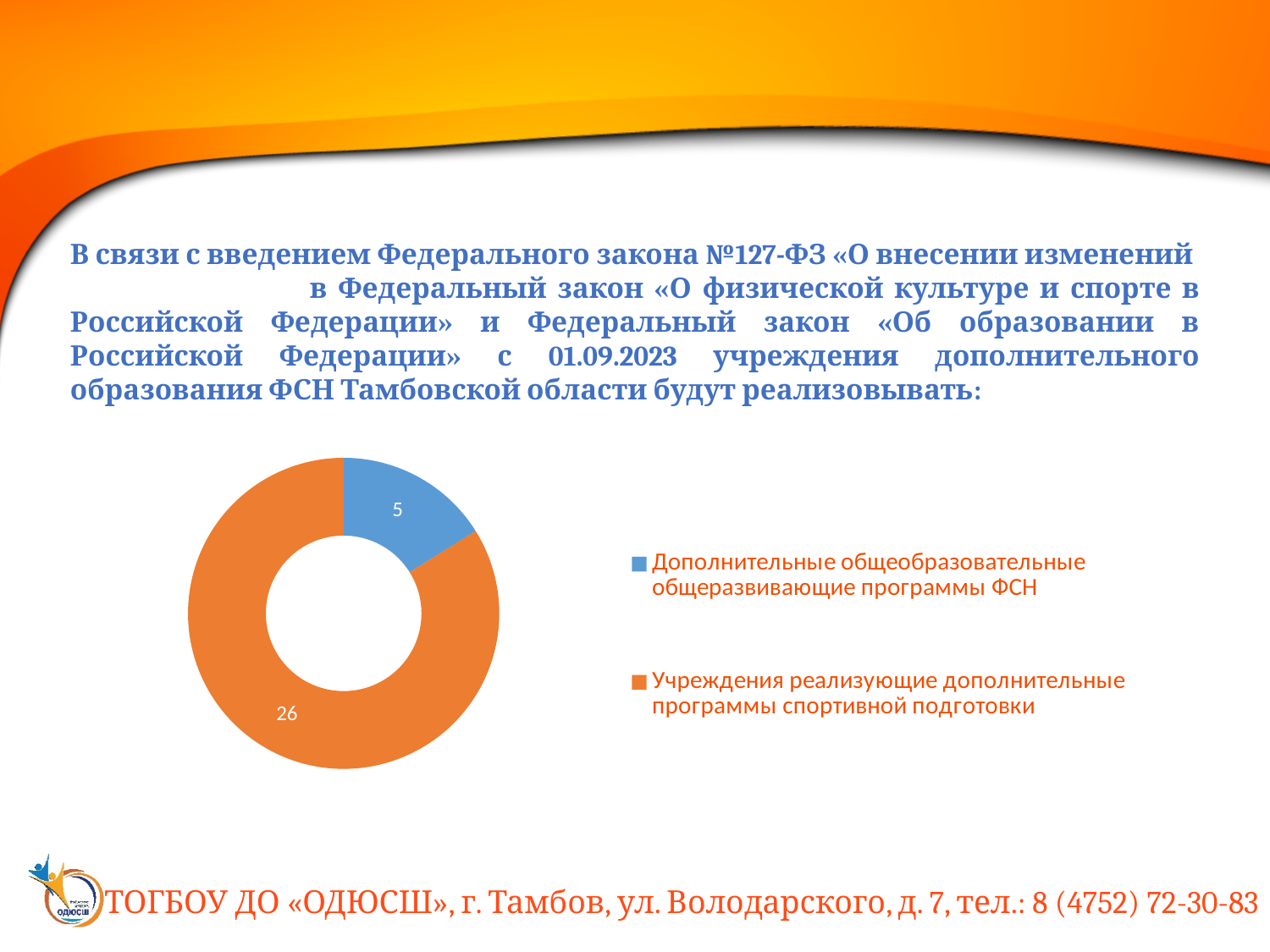
What is the total of the two values shown in the chart? 31 What is the difference between the two values shown in the chart? 21 What colour is the slice for 'Дополнительные общеобразовательные общеразвивающие программы ФСН'? Blue Which category has the largest slice in the chart? Учреждения реализующие дополнительные программы спортивной подготовки How many entries does the legend list? 2 Which category has the smallest slice in the chart? Дополнительные общеобразовательные общеразвивающие программы ФСН What value is shown for the slice 'Дополнительные общеобразовательные общеразвивающие программы ФСН'? 5 What value is shown for the slice 'Учреждения реализующие дополнительные программы спортивной подготовки'? 26 How many slices does the chart have? 2 What kind of chart is shown on the slide? Doughnut (pie) chart Which is larger: the value for 'Дополнительные общеобразовательные общеразвивающие программы ФСН' or for 'Учреждения реализующие дополнительные программы спортивной подготовки'? Учреждения реализующие дополнительные программы спортивной подготовки